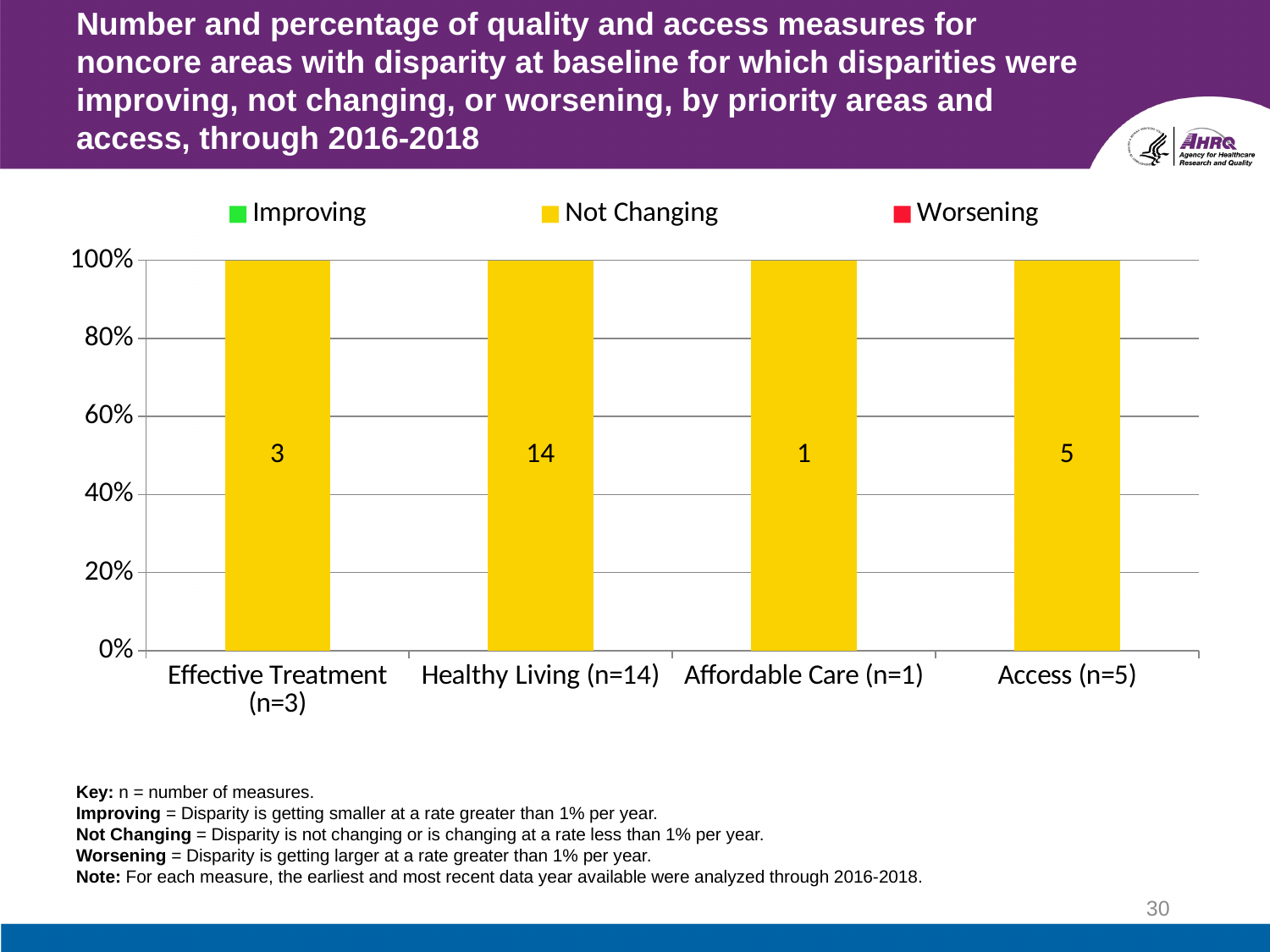
How many categories are shown on the x axis? 4 What is the data label shown on the Access (n=5) bar? 5 What is the data label shown on the Effective Treatment (n=3) bar? 3 What percentage of the Access (n=5) bar is made up of Not Changing measures? 100% Which has more Not Changing measures, Access or Effective Treatment? Access What is the difference between the number of Not Changing measures for Healthy Living and for Effective Treatment? 11 What is the data label shown on the Healthy Living (n=14) bar? 14 Which category has the largest number of Not Changing measures? Healthy Living (n=14) What kind of chart is shown on the slide? Stacked bar chart Which category has the smallest number of Not Changing measures? Affordable Care (n=1) What is the data label shown on the Affordable Care (n=1) bar? 1 How many series does the legend list? 3